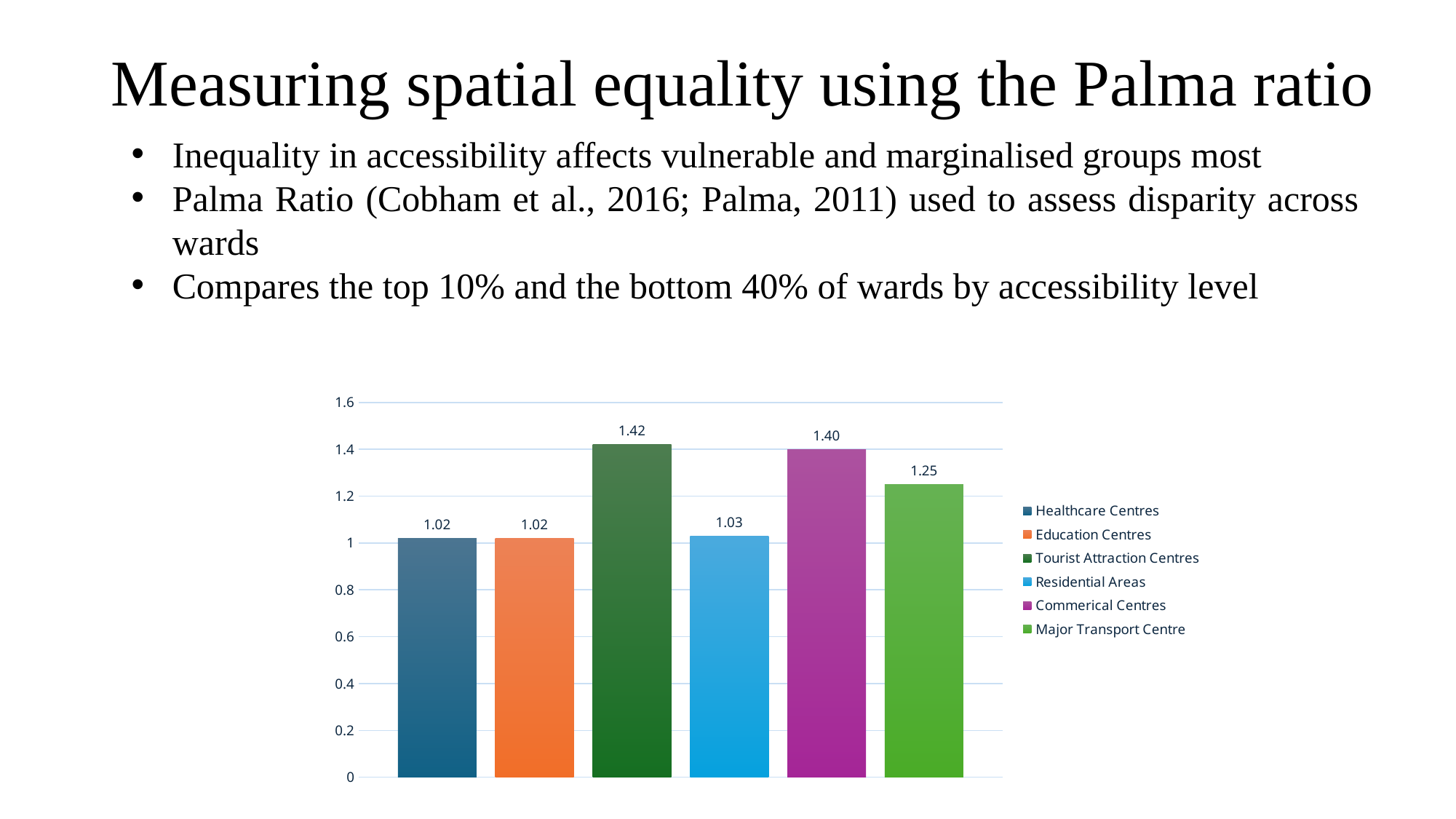
Which category has the highest value? Tourist Attraction Centres How many bars are plotted in the chart? 6 What is the value shown for Residential Areas? 1.03 Which is larger, the value for Major Transport Centre or the value for Education Centres? Major Transport Centre What is the value shown for Commerical Centres? 1.40 How many entries does the legend list? 6 What kind of chart is shown on the slide? Bar chart What is the difference between the values for Tourist Attraction Centres and Residential Areas? 0.39 What is the value shown for Major Transport Centre? 1.25 What is the Palma ratio value for Tourist Attraction Centres? 1.42 What is the difference between the values for Commerical Centres and Major Transport Centre? 0.15 Is the value for Commerical Centres greater or less than 1.2? greater